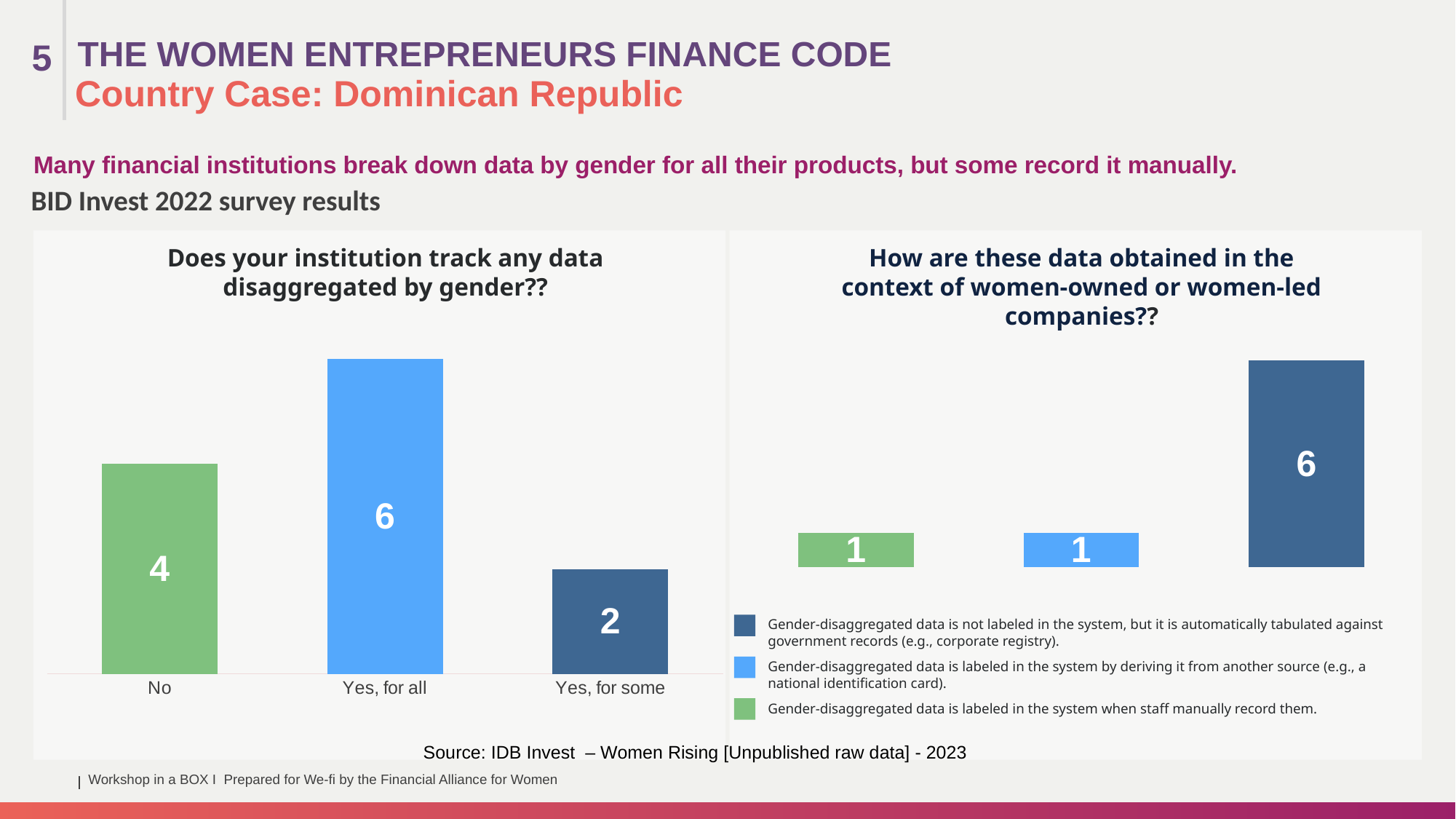
In the chart titled "Does your institution track any data disaggregated by gender??", what is the difference between the values for "Yes, for all" and "No"? 2 In the chart titled "Does your institution track any data disaggregated by gender??", how many categories are shown? 3 In the chart titled "Does your institution track any data disaggregated by gender??", what is the value for "Yes, for some"? 2 In the chart on the right, what is the value for the bar representing data that is not labeled in the system but automatically tabulated against government records? 6 In the chart titled "Does your institution track any data disaggregated by gender??", which category has the highest value? Yes, for all In the chart titled "Does your institution track any data disaggregated by gender??", what is the value for "Yes, for all"? 6 In the chart on the right, what is the value for the bar representing data labeled in the system when staff manually record them? 1 In the chart titled "Does your institution track any data disaggregated by gender??", which category has the lowest value? Yes, for some In the chart on the right, what is the difference between the highest bar and the bar for data labeled by deriving it from another source? 5 What kind of chart is the one on the left of the slide? Bar chart In the chart on the right, how many entries does the legend list? 3 In the chart titled "Does your institution track any data disaggregated by gender??", what is the value for "No"? 4